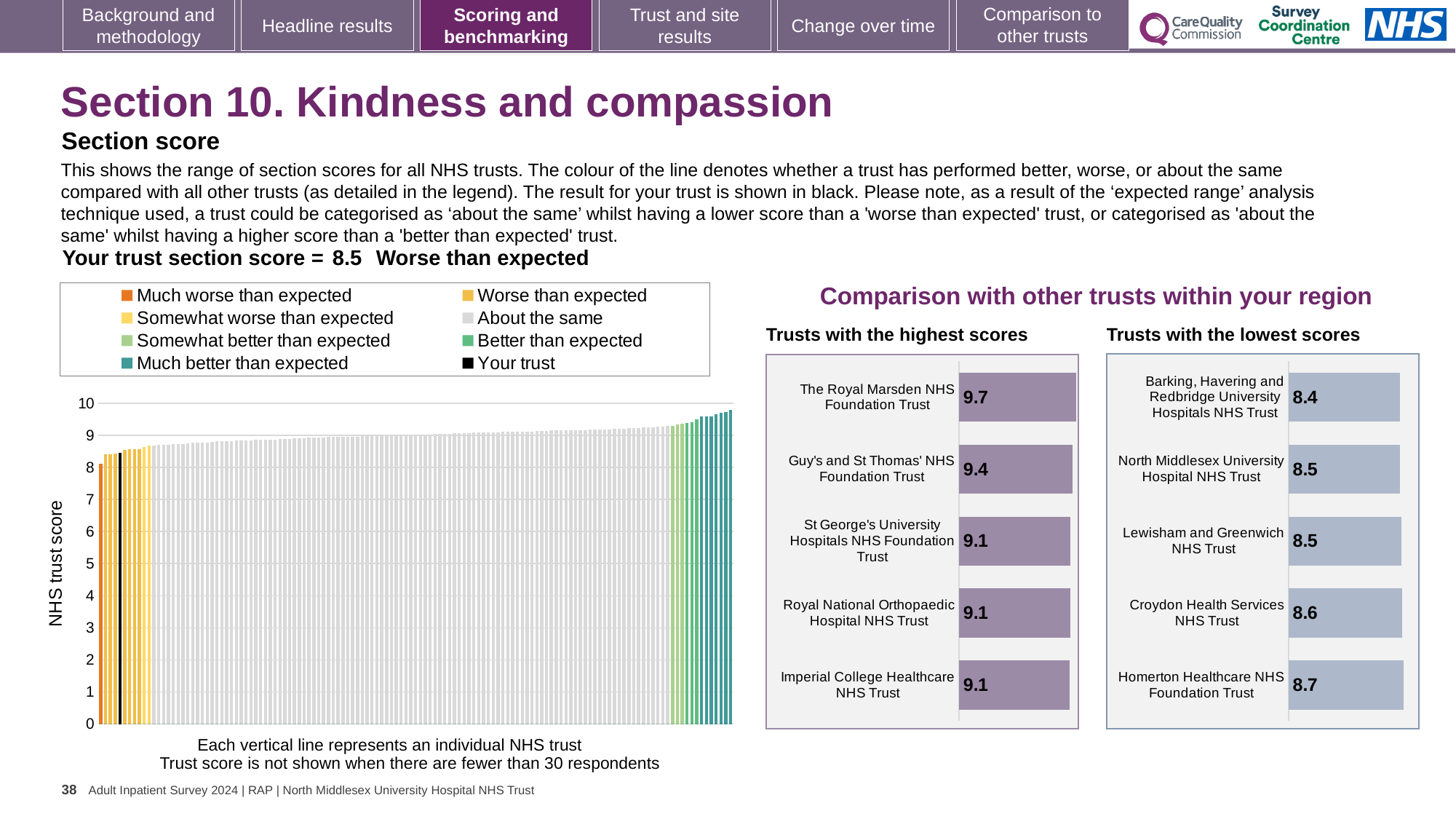
In the 'Trusts with the lowest scores' chart, which trust has the lowest score? Barking, Havering and Redbridge University Hospitals NHS Trust How many trusts are shown in the 'Trusts with the lowest scores' chart? 5 How many trusts are shown in the 'Trusts with the highest scores' chart? 5 In the 'Trusts with the highest scores' chart, which trust has the highest score? The Royal Marsden NHS Foundation Trust In the 'Trusts with the lowest scores' chart, which has the larger score: Croydon Health Services NHS Trust or Lewisham and Greenwich NHS Trust? Croydon Health Services NHS Trust How many entries does the legend of the large 'NHS trust score' chart list? 8 In the 'Trusts with the highest scores' chart, what is the difference between the scores of The Royal Marsden NHS Foundation Trust and Guy's and St Thomas' NHS Foundation Trust? 0.3 In the 'Trusts with the highest scores' chart, what is the score for The Royal Marsden NHS Foundation Trust? 9.7 In the 'Trusts with the lowest scores' chart, what is the score for Homerton Healthcare NHS Foundation Trust? 8.7 According to the slide, what is your trust's section score for Section 10, Kindness and compassion? 8.5 In the large 'NHS trust score' chart, what colour represents 'Your trust' in the legend? Black What kind of chart is the large 'NHS trust score' chart on the left of the slide? bar chart